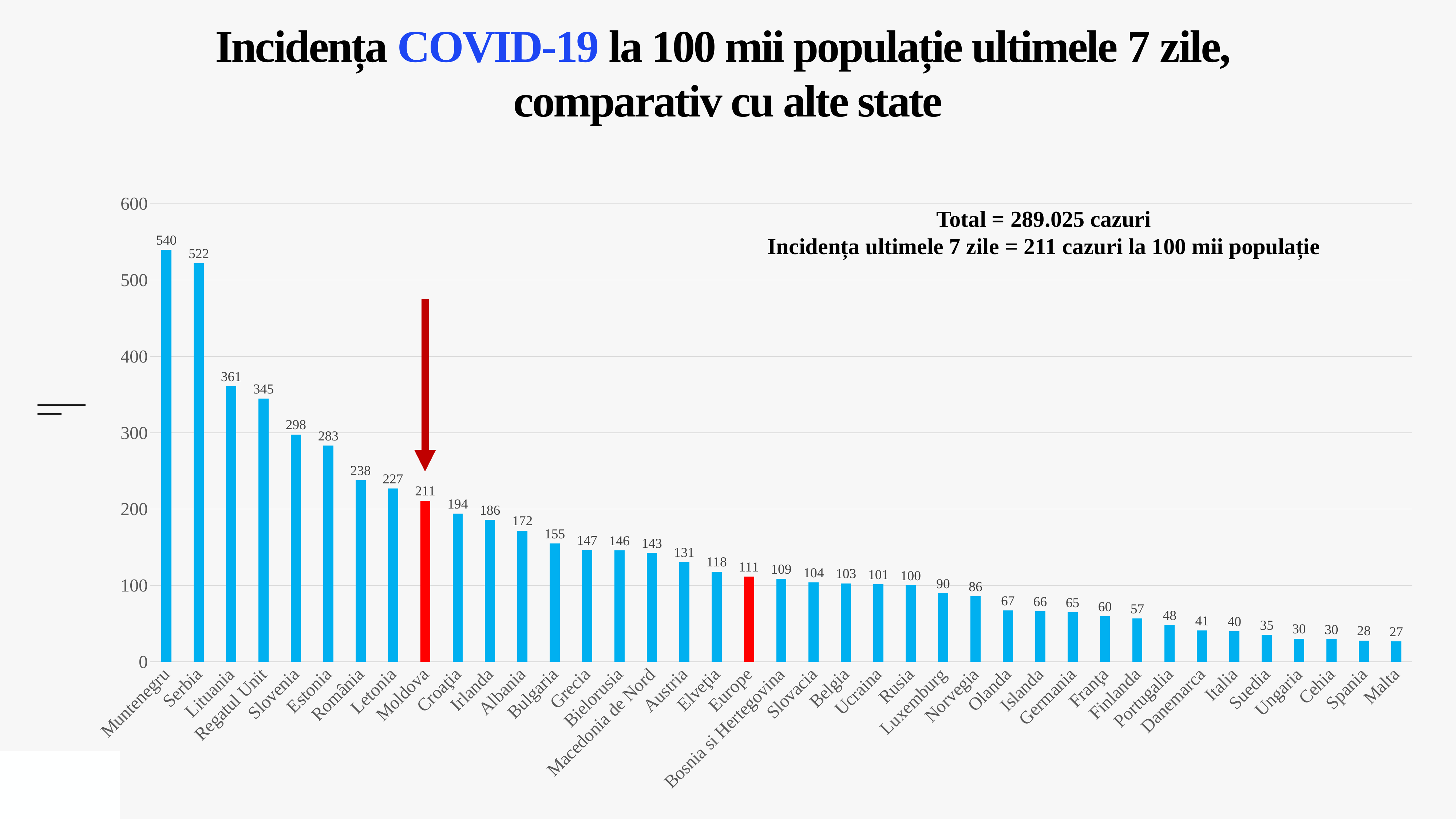
Which bars are coloured red instead of blue? Moldova and Europe Which country has the highest incidence? Muntenegru Do the values rise or fall from left to right along the x axis? fall What is the value for Regatul Unit? 345 Which has a higher value, România or Croația? România What is the difference between the values for Muntenegru and Serbia? 18 What is the difference between the values for Moldova and Europe? 100 What is the value for Moldova? 211 Which country has the lowest incidence? Malta What is the value for Europe? 111 What kind of chart is shown on the slide? bar chart How many countries or regions are shown on the x axis? 39